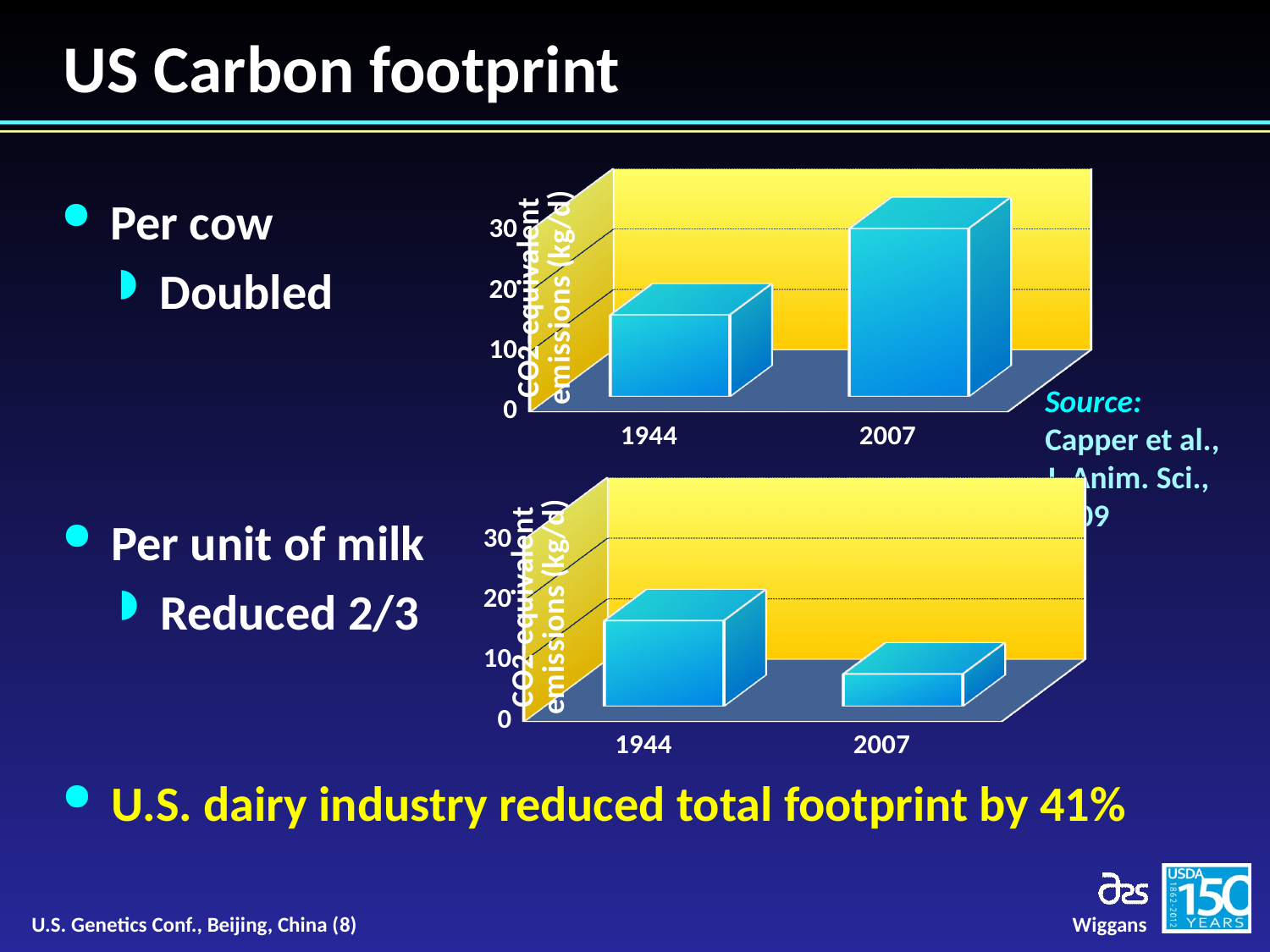
What kind of chart is the bottom chart (per unit of milk)? bar chart What is the y-axis label of the top chart (per cow)? CO2 equivalent emissions (kg/d) How many categories are shown on the x axis of the top chart (per cow)? 2 In the top chart (per cow), do the values rise or fall from 1944 to 2007? rise What kind of chart is the top chart (per cow)? bar chart In the bottom chart (per unit of milk), which year has the lower CO2 equivalent emissions? 2007 In the top chart (per cow), which year has the higher CO2 equivalent emissions? 2007 In the bottom chart (per unit of milk), is the value for 1944 larger or smaller than the value for 2007? larger In the top chart (per cow), is the value for 2007 greater or less than 20? greater In the bottom chart (per unit of milk), is the value for 2007 greater or less than 10? less In the bottom chart (per unit of milk), is the value for 1944 greater or less than 10? greater